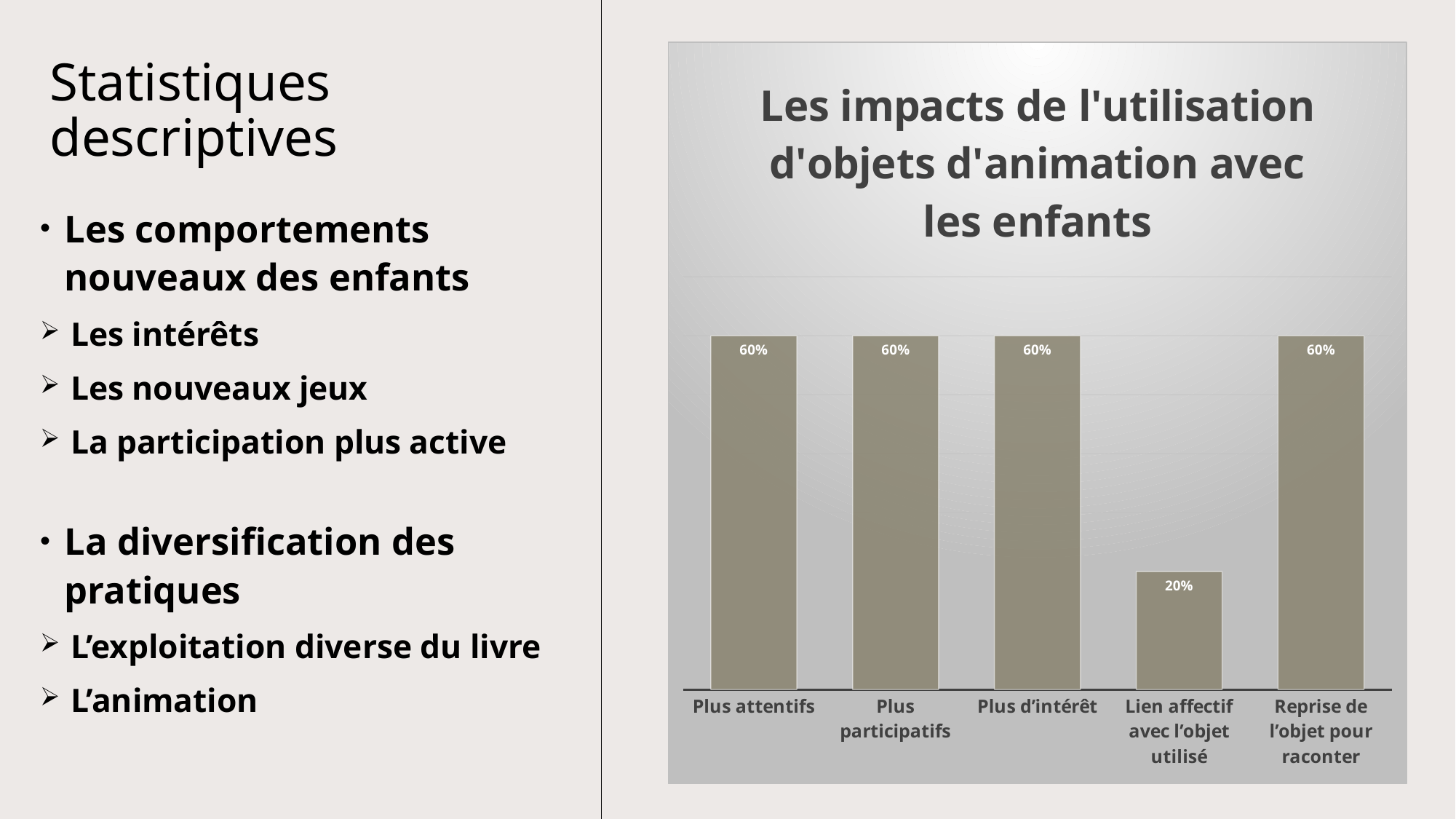
What is the difference between the values for "Plus d'intérêt" and "Lien affectif avec l'objet utilisé"? 40% What is the value for "Lien affectif avec l'objet utilisé"? 20% What is the value for "Plus participatifs"? 60% What is the value for "Plus attentifs"? 60% How many categories have a value of 60%? 4 Which is larger, the value for "Plus attentifs" or the value for "Lien affectif avec l'objet utilisé"? Plus attentifs Which category has the lowest value? Lien affectif avec l'objet utilisé How many categories are shown in the chart? 5 What kind of chart is shown on the slide? Bar chart What is the value for "Reprise de l'objet pour raconter"? 60% What is the title of the chart? Les impacts de l'utilisation d'objets d'animation avec les enfants